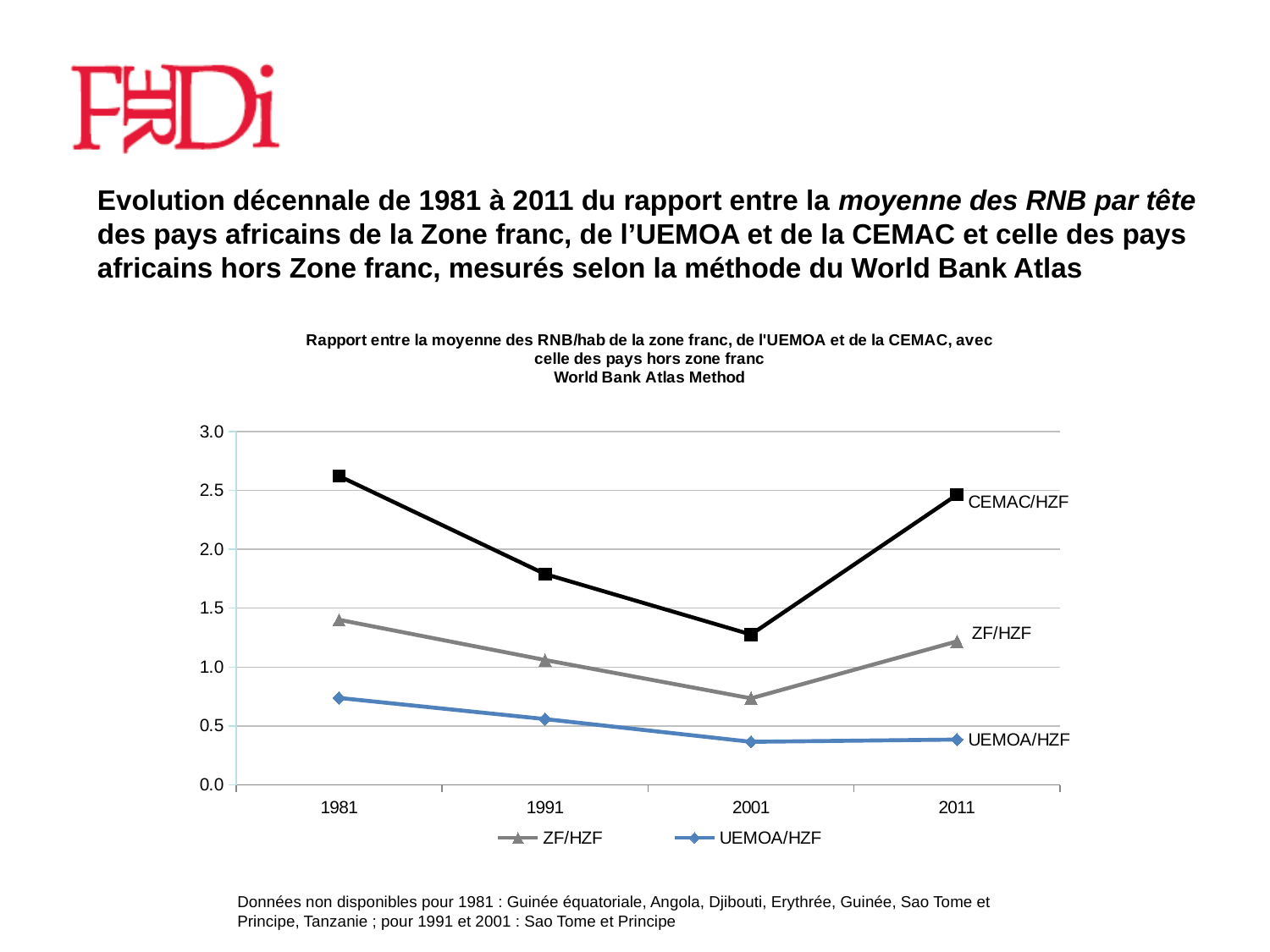
Does the ZF/HZF ratio rise or fall from 1981 to 2001? fall How many series does the legend below the chart list? 2 What kind of chart is shown on the slide? line chart Is the value for UEMOA/HZF in 1981 greater or less than 0.5? greater Is the value for CEMAC/HZF in 1981 greater or less than 2.5? greater Is the value for ZF/HZF in 2001 greater or less than 1.0? less In which year is the ZF/HZF ratio lowest? 2001 In 2001, which is larger: the CEMAC/HZF ratio or the ZF/HZF ratio? CEMAC/HZF In which year is the CEMAC/HZF ratio highest? 1981 Which series is labelled at the top of the chart but does not appear in the legend? CEMAC/HZF How many years are plotted along the x axis? 4